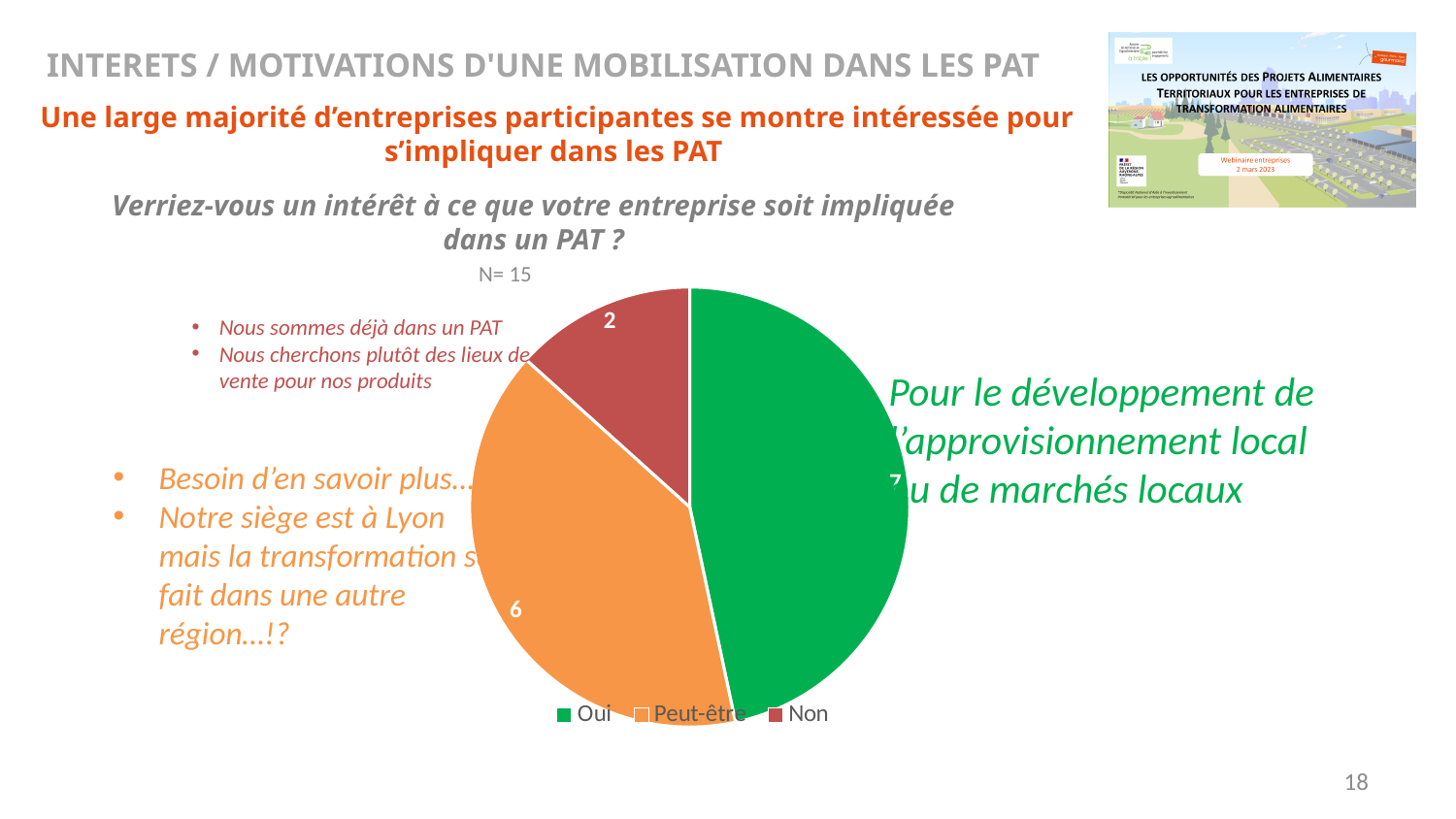
Which is larger in the pie chart, 'Peut-être' or 'Non'? Peut-être How many slices does the pie chart have? 3 What is the difference between the 'Peut-être' value and the 'Non' value in the pie chart? 4 What is the value shown for the 'Non' slice of the pie chart? 2 What is the value shown for the 'Peut-être' slice of the pie chart? 6 How many entries does the legend of the pie chart list? 3 Which category has the smallest slice in the pie chart? Non Which category has the largest slice in the pie chart? Oui What sample size (N) is indicated above the pie chart? N= 15 Which is larger in the pie chart, 'Oui' or 'Non'? Oui What kind of chart is shown on the slide? pie chart What colour is the 'Oui' slice in the pie chart? green